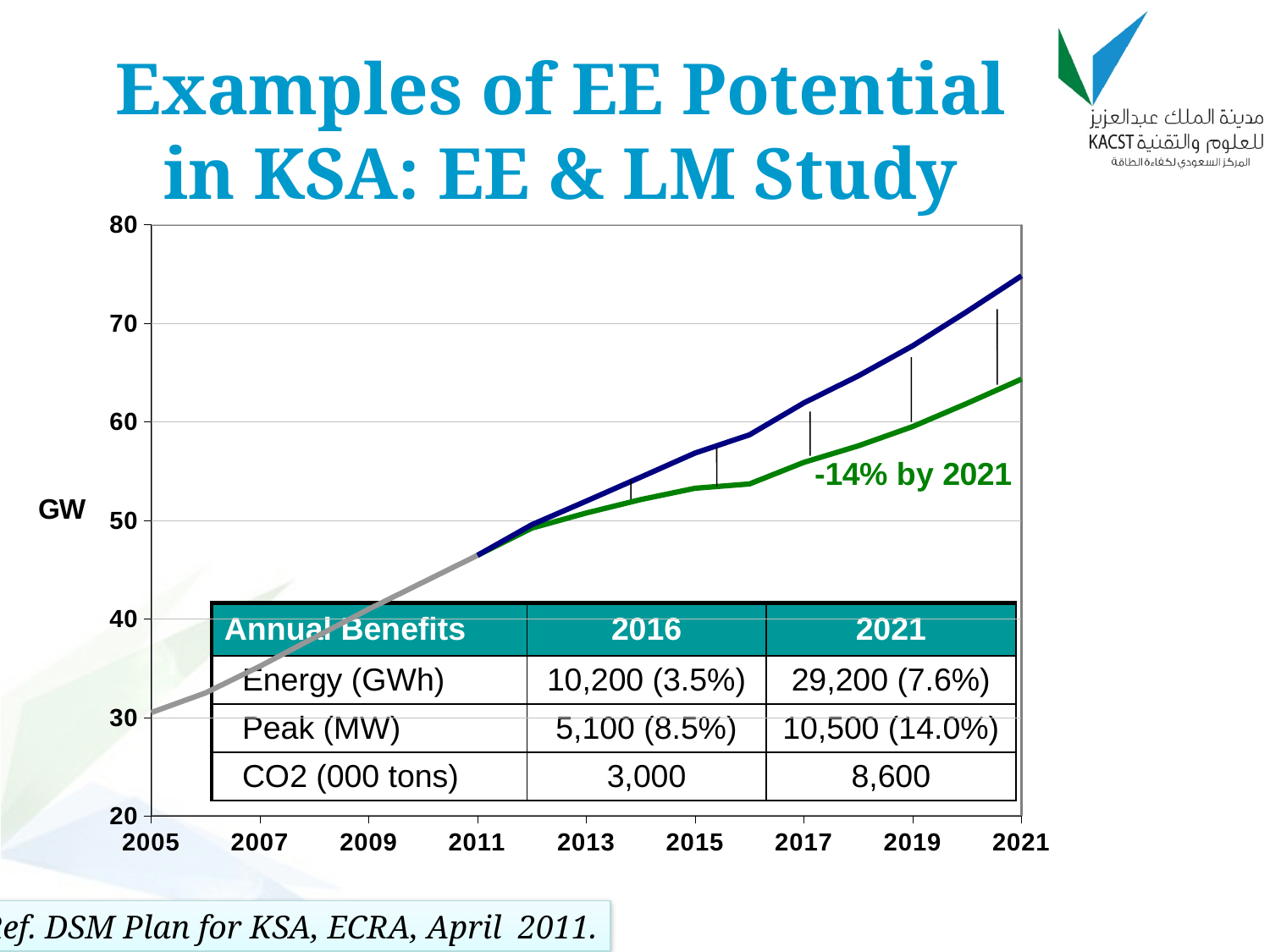
Is the value of the blue line in 2019 greater or less than 60? greater What is the label on the y axis of the chart? GW Is the value of the blue line in 2021 greater or less than 70? greater What kind of chart is shown on the slide? line chart How many year labels are shown along the x axis of the chart? 9 Is the value of the green line in 2021 greater or less than 70? less In 2021, which line is higher, the blue line or the green line? the blue line What is the highest value shown on the y axis of the chart? 80 What percentage reduction by 2021 is annotated next to the green line? -14% by 2021 Do the plotted lines rise or fall from 2005 to 2021? rise